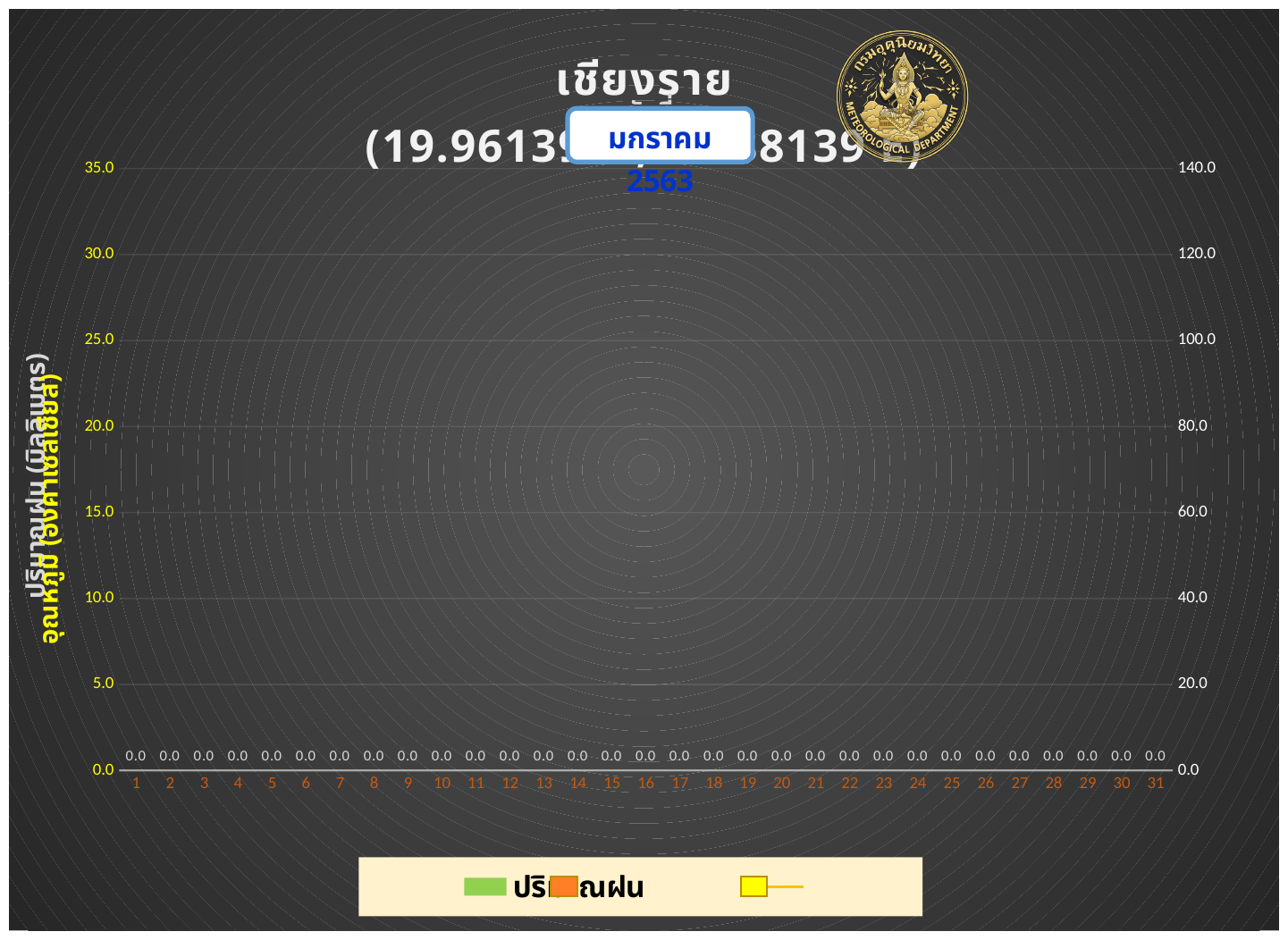
What is the value printed for day 1? 0.0 Which month and year are shown on the chart? มกราคม 2563 Is the value for day 20 greater or less than 20.0 on the right axis? less How many days are shown along the x axis? 31 What is the value printed for day 15? 0.0 What is the main title of the chart? เชียงราย What is the value printed for day 31? 0.0 Is the value for day 10 greater or less than 5.0? less What is the first label on the x axis? 1 What is the last label on the x axis? 31 What is the difference between the values for day 1 and day 2? 0.0